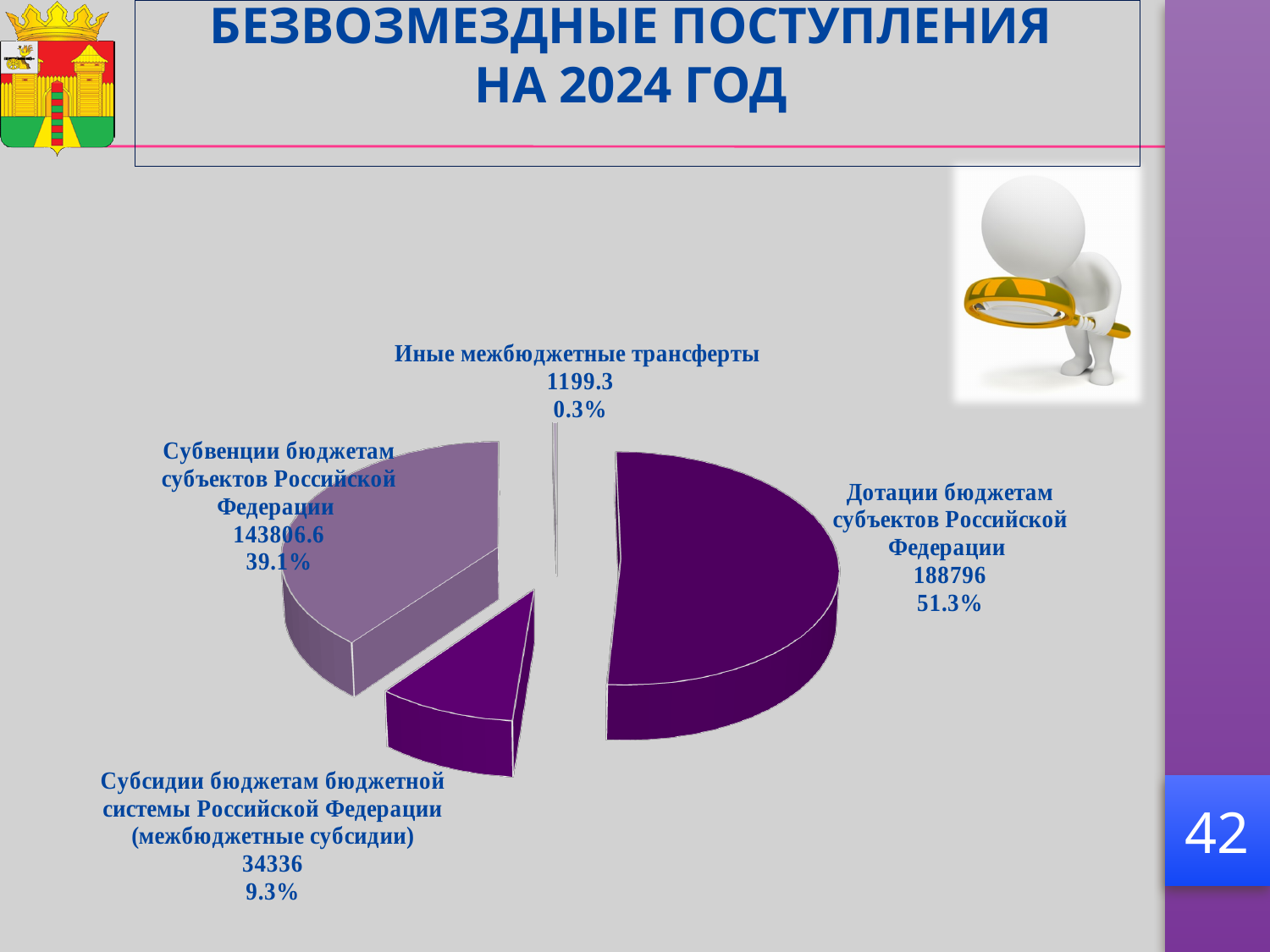
What share of the pie is Субвенции бюджетам субъектов Российской Федерации? 39.1% What share of the pie is Иные межбюджетные трансферты? 0.3% Which category has the largest share of the pie? Дотации бюджетам субъектов Российской Федерации What type of chart is shown on the slide? pie chart What is the value for Иные межбюджетные трансферты? 1199.3 Which is larger: the value for Субсидии бюджетам бюджетной системы Российской Федерации or the value for Иные межбюджетные трансферты? Субсидии бюджетам бюджетной системы Российской Федерации What is the title of the slide containing the pie chart? БЕЗВОЗМЕЗДНЫЕ ПОСТУПЛЕНИЯ НА 2024 ГОД What is the value for Субсидии бюджетам бюджетной системы Российской Федерации (межбюджетные субсидии)? 34336 Which category has the smallest share of the pie? Иные межбюджетные трансферты How many slices does the pie chart have? 4 What is the value for Дотации бюджетам субъектов Российской Федерации? 188796 What is the difference between the values for Дотации бюджетам субъектов Российской Федерации and Субвенции бюджетам субъектов Российской Федерации? 44989.4